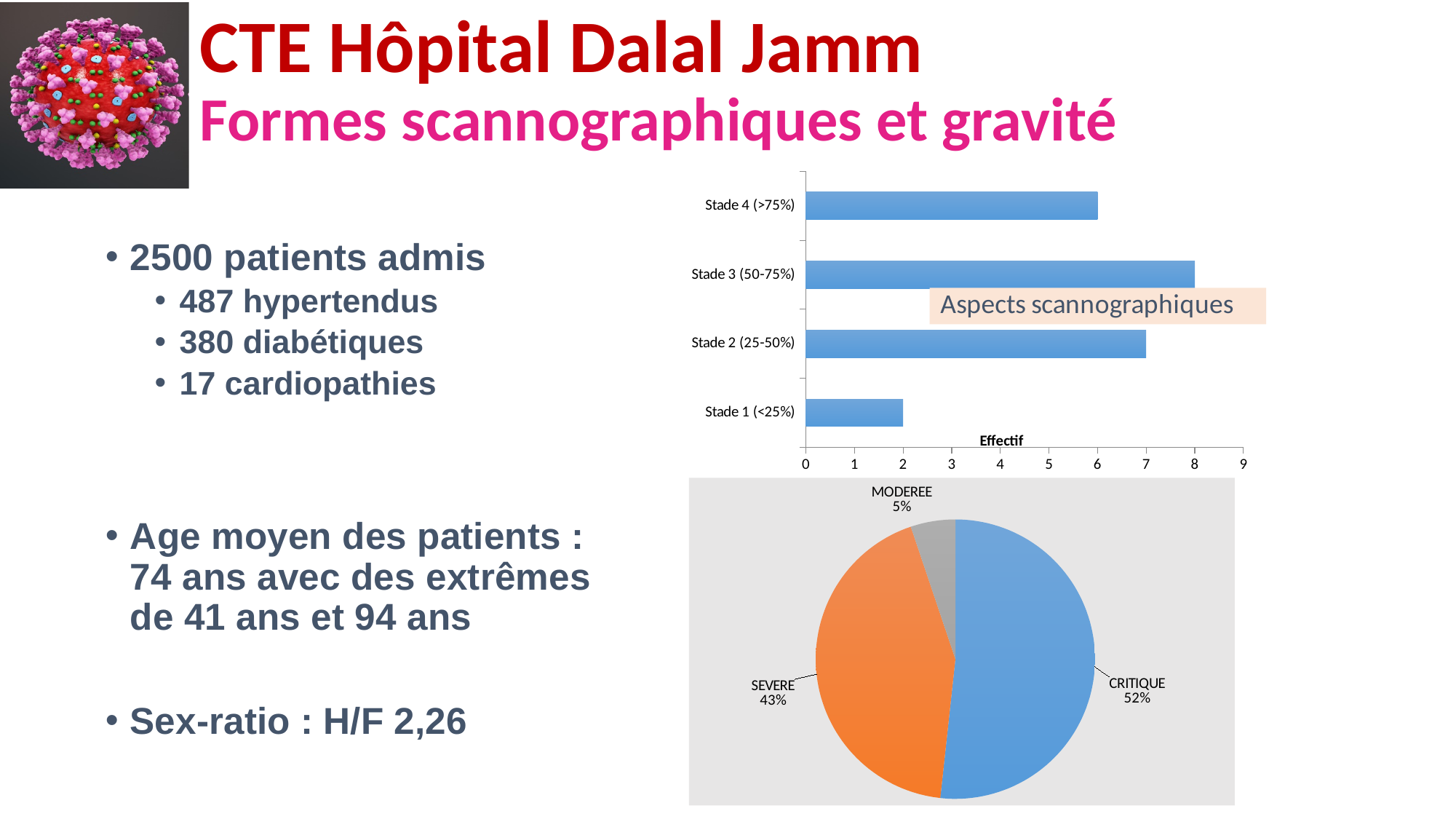
In the bar chart 'Aspects scannographiques', which is larger: the value for Stade 2 (25-50%) or Stade 4 (>75%)? Stade 2 (25-50%) What kind of chart is the 'Aspects scannographiques' chart? bar chart In the bar chart 'Aspects scannographiques', how many stages are shown? 4 In the bar chart 'Aspects scannographiques', what is the value for Stade 3 (50-75%)? 8 In the bar chart 'Aspects scannographiques', what is the label of the horizontal axis? Effectif In the bar chart 'Aspects scannographiques', which stage has the highest value? Stade 3 (50-75%) In the pie chart at the bottom right, what share is labelled CRITIQUE? 52% In the pie chart at the bottom right, how many slices are there? 3 In the bar chart 'Aspects scannographiques', which stage has the lowest value? Stade 1 (<25%) In the bar chart 'Aspects scannographiques', what is the value for Stade 1 (<25%)? 2 In the pie chart at the bottom right, which category has the smallest slice? MODEREE In the pie chart at the bottom right, what share is labelled SEVERE? 43%